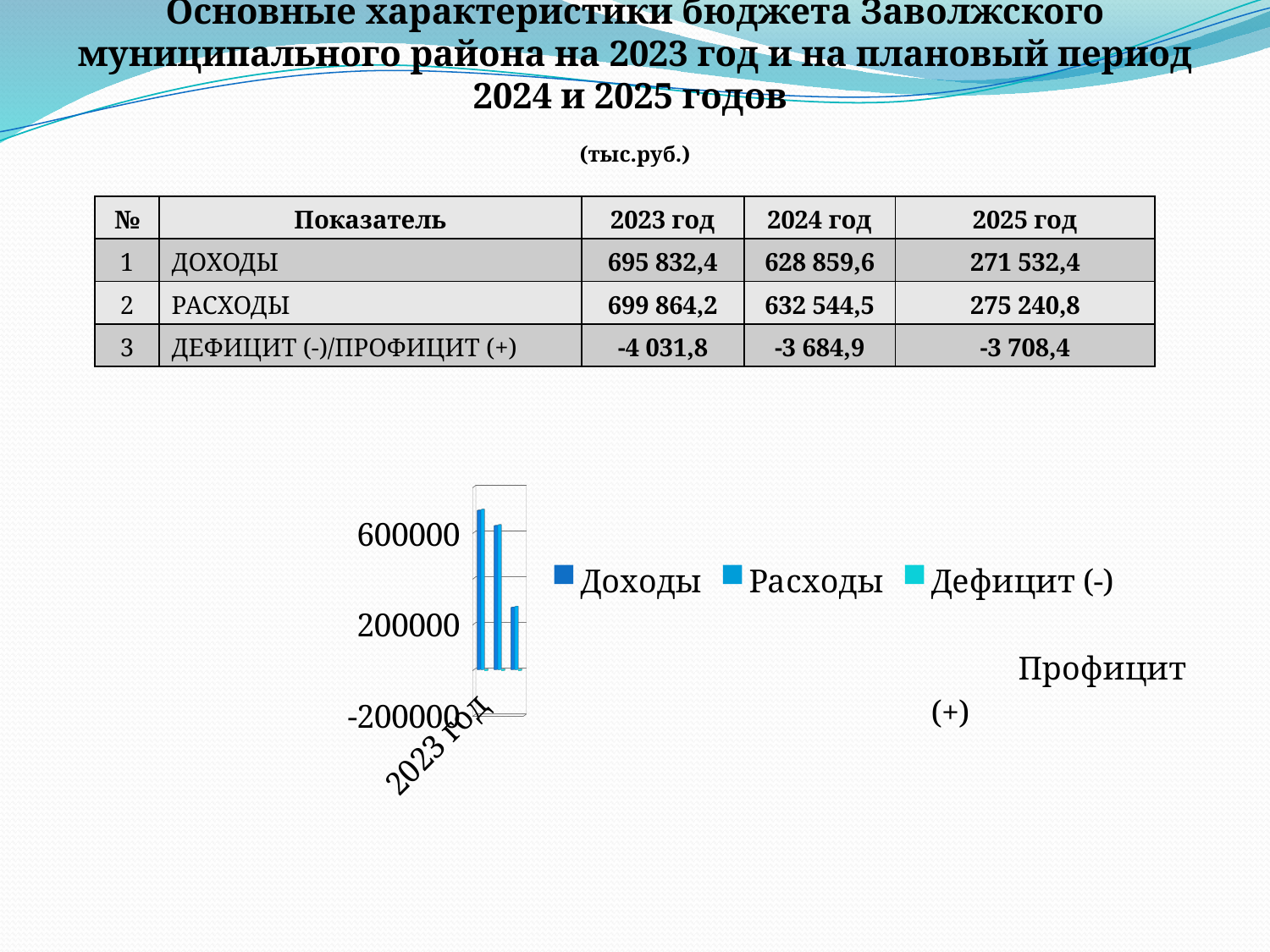
What is the first series listed in the chart legend? Доходы What kind of chart is shown on the slide? bar chart Which category label is readable on the chart's horizontal axis? 2023 год How many series does the chart legend list? 3 Do the bars in the chart rise or fall from left to right? fall What is the highest value labelled on the chart's vertical axis? 600000 What is the lowest value labelled on the chart's vertical axis? -200000 What is the second series listed in the chart legend? Расходы Is the value of the tallest bar in the chart greater or less than 200000? greater